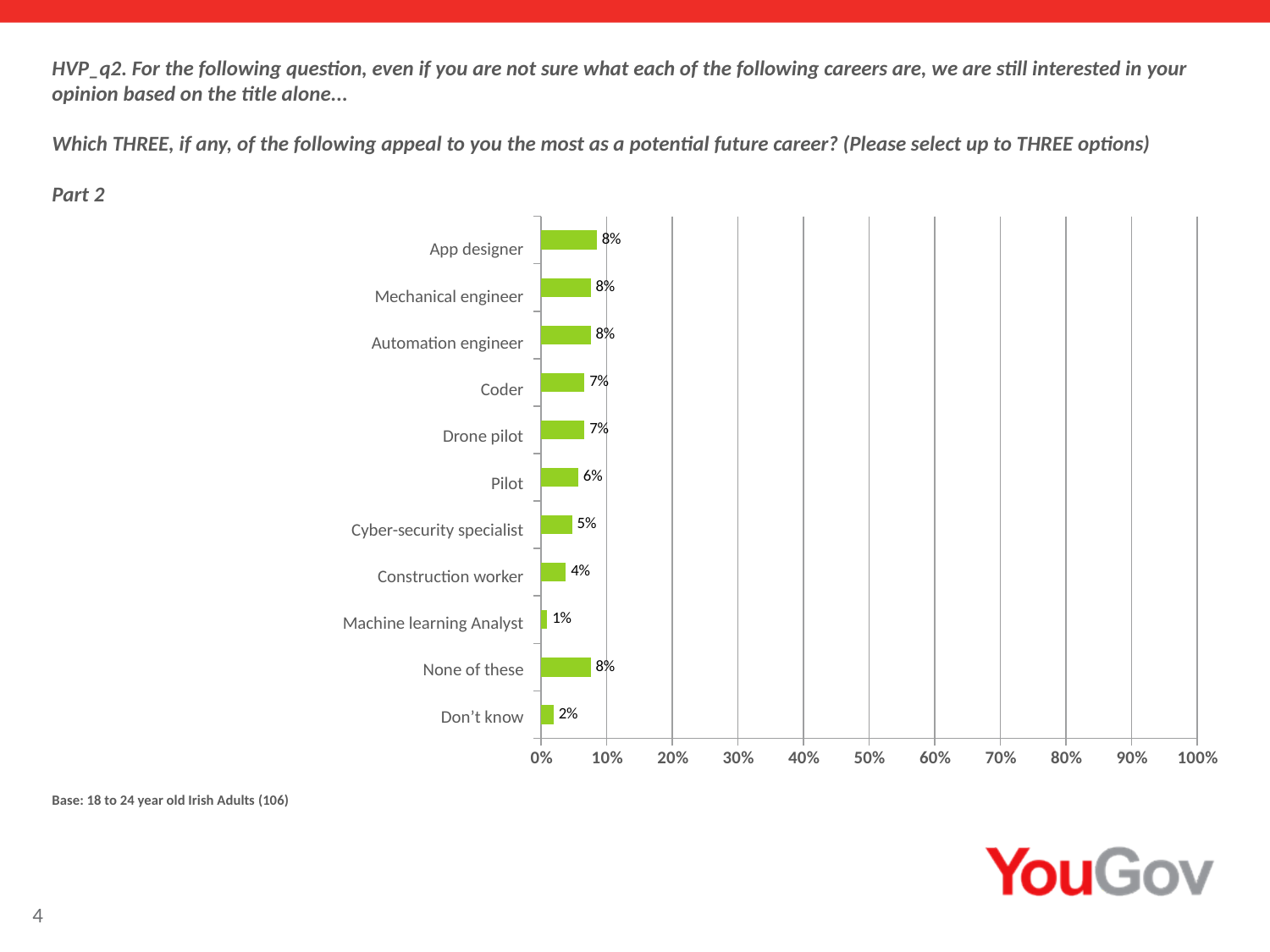
What percentage of respondents selected Coder as an appealing future career? 7% What percentage is shown for Machine learning Analyst? 1% What is the value shown for Cyber-security specialist? 5% How many categories are shown on the chart? 11 What is the difference between the values for Pilot and Don't know? 4% Which career option has the lowest percentage on the chart? Machine learning Analyst Which has a higher value, Pilot or Construction worker? Pilot What is the difference between the values for Coder and Construction worker? 3% What kind of chart is shown on the slide? Bar chart What colour are the bars in the chart? Green Is the value for App designer greater or less than 10%? less What is the value for Don't know? 2%